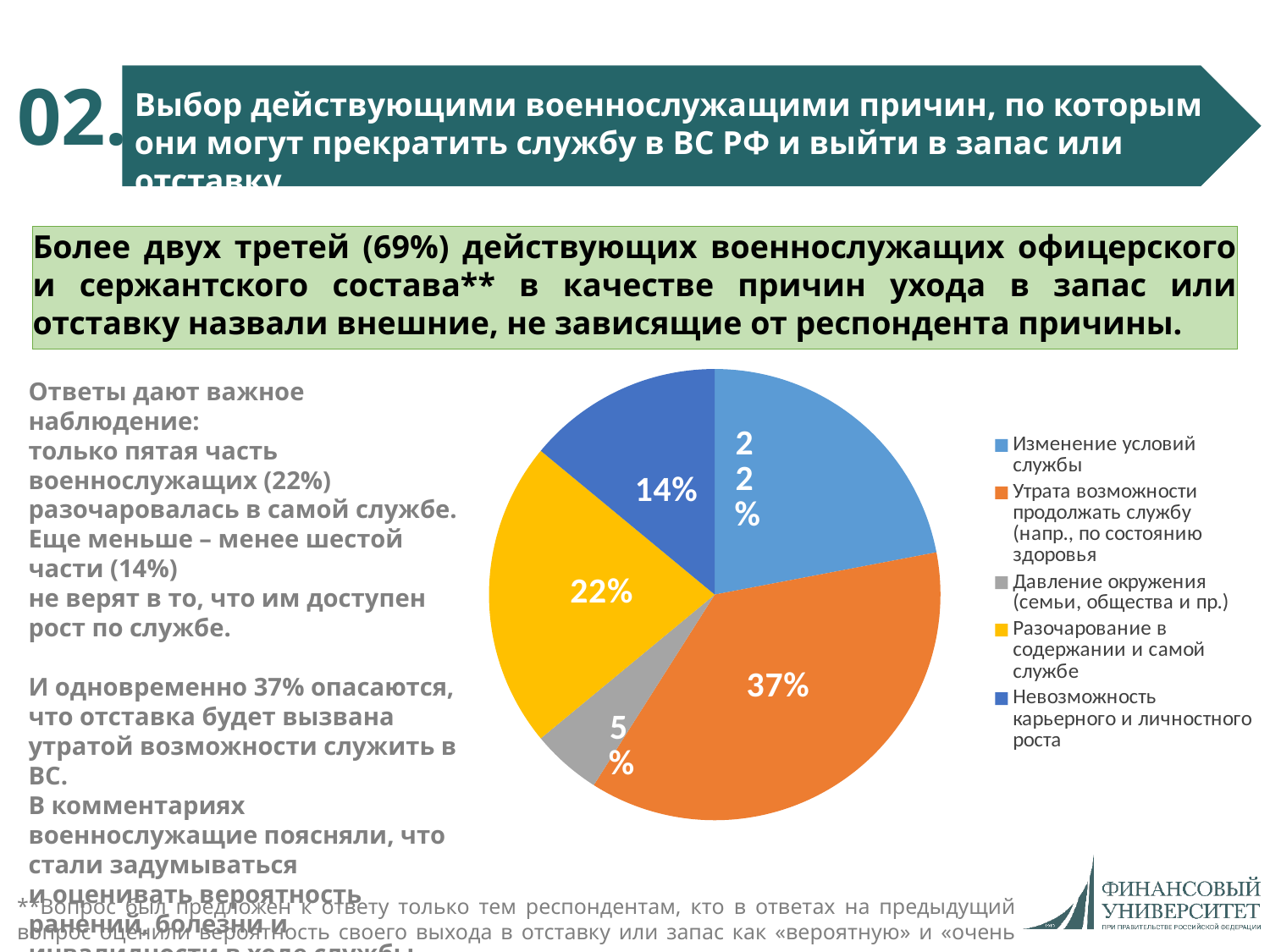
What share of the pie is labelled for 'Невозможность карьерного и личностного роста'? 14% How many slices does the pie chart have? 5 What colour is the slice for 'Разочарование в содержании и самой службе'? yellow What share of the pie is labelled for 'Разочарование в содержании и самой службе'? 22% Which slice is larger: 'Невозможность карьерного и личностного роста' or 'Утрата возможности продолжать службу'? Утрата возможности продолжать службу How many entries does the legend of the pie chart list? 5 What is the difference in percentage points between the 'Утрата возможности продолжать службу' slice and the 'Давление окружения' slice? 32 What type of chart is shown on the slide? pie chart What share of the pie is labelled for 'Утрата возможности продолжать службу (напр., по состоянию здоровья)'? 37% What share of the pie is labelled for 'Давление окружения (семьи, общества и пр.)'? 5% Which category has the largest slice of the pie? Утрата возможности продолжать службу (напр., по состоянию здоровья) Which category has the smallest slice of the pie? Давление окружения (семьи, общества и пр.)